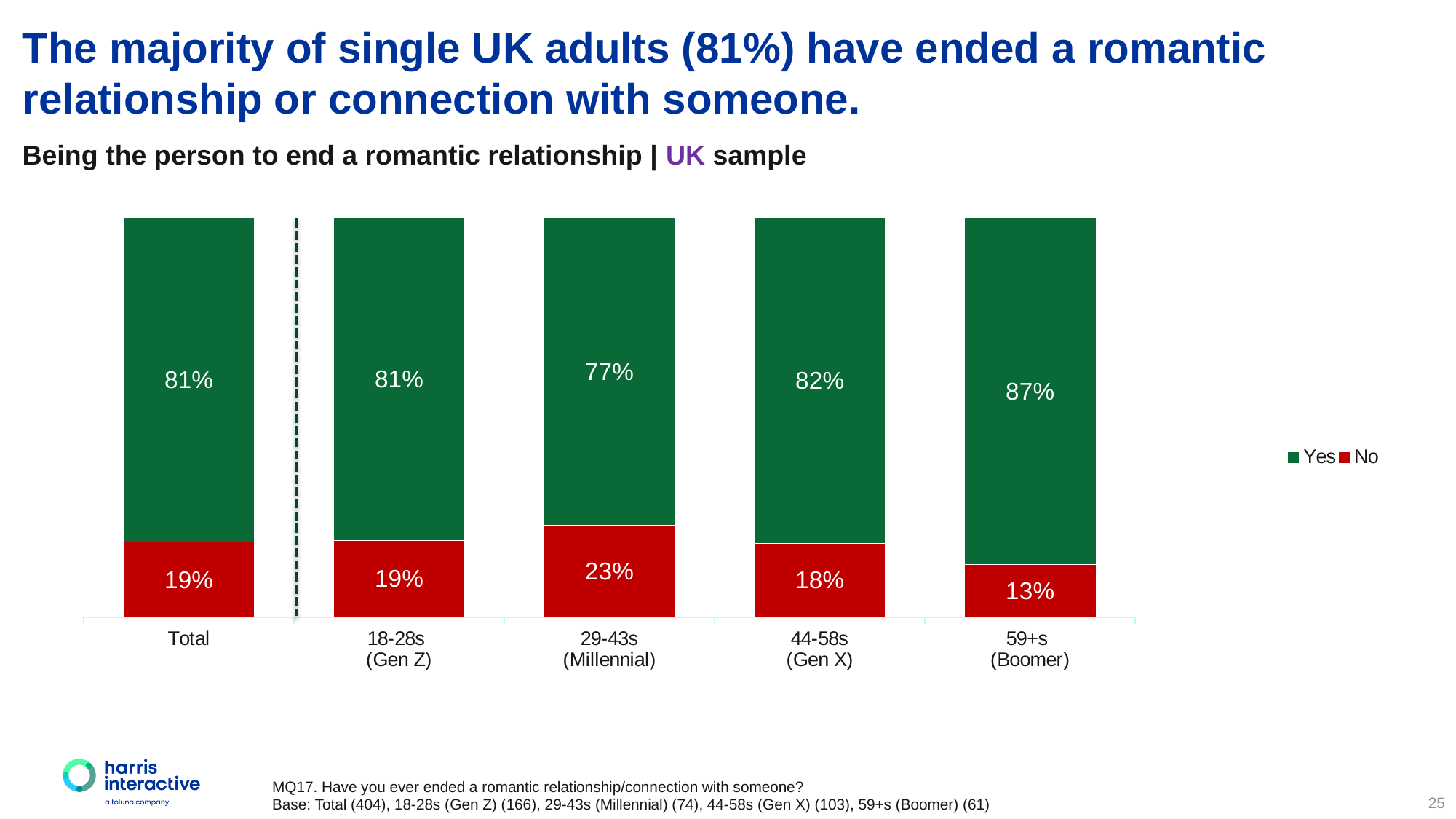
Which colour represents the No responses in the chart? Red Which age group has the highest Yes percentage? 59+s (Boomer) What is the Yes value for 59+s (Boomer)? 87% Which age group has the lowest Yes percentage? 29-43s (Millennial) Which is larger, the No value for 18-28s (Gen Z) or the No value for 59+s (Boomer)? 18-28s (Gen Z) What kind of chart is shown on the slide? Stacked bar chart How many categories are shown on the x axis? 5 What percentage of 29-43s (Millennial) answered No? 23% How many series does the legend list? 2 What is the difference between the Yes percentages for 59+s (Boomer) and 29-43s (Millennial)? 10% What percentage of the Total group answered Yes? 81% What is the No value for 44-58s (Gen X)? 18%